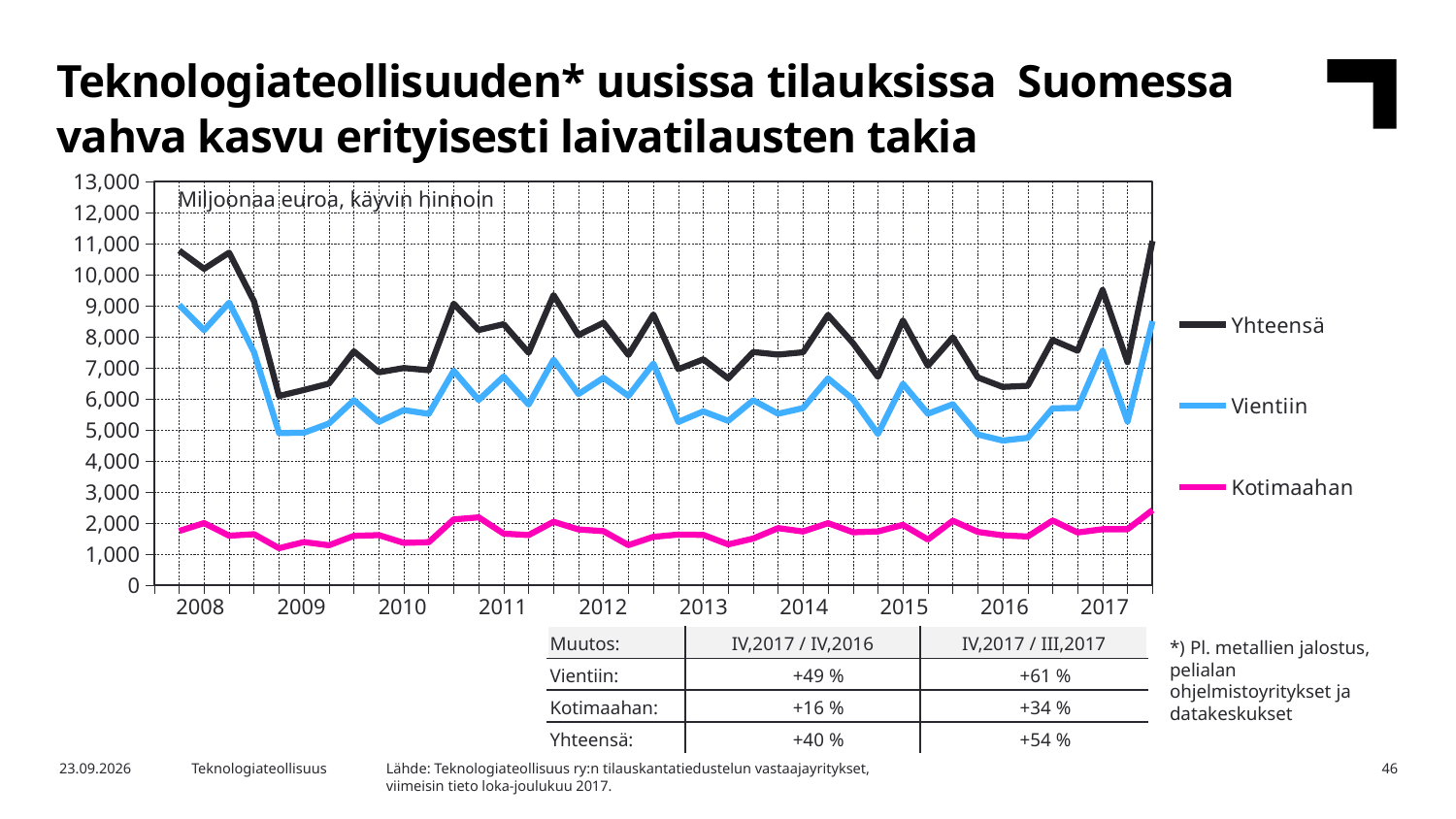
Is the value for Kotimaahan at the start of 2008 greater or less than 3,000? less Which series has the lowest values throughout the chart? Kotimaahan Which series is shown in black in the chart? Yhteensä Which series is larger at the start of 2008, Vientiin or Kotimaahan? Vientiin What kind of chart is shown on the slide? line chart Is the value for Vientiin at the start of 2008 greater or less than 8,000? greater Which series has the highest values throughout the chart? Yhteensä Does the Yhteensä line rise or fall from the start of 2008 to 2009? fall How many year labels are shown on the x axis? 10 What unit label is printed inside the chart area? Miljoonaa euroa, käyvin hinnoin How many series does the chart legend list? 3 Is the last plotted value for Yhteensä in 2017 greater or less than 10,000? greater